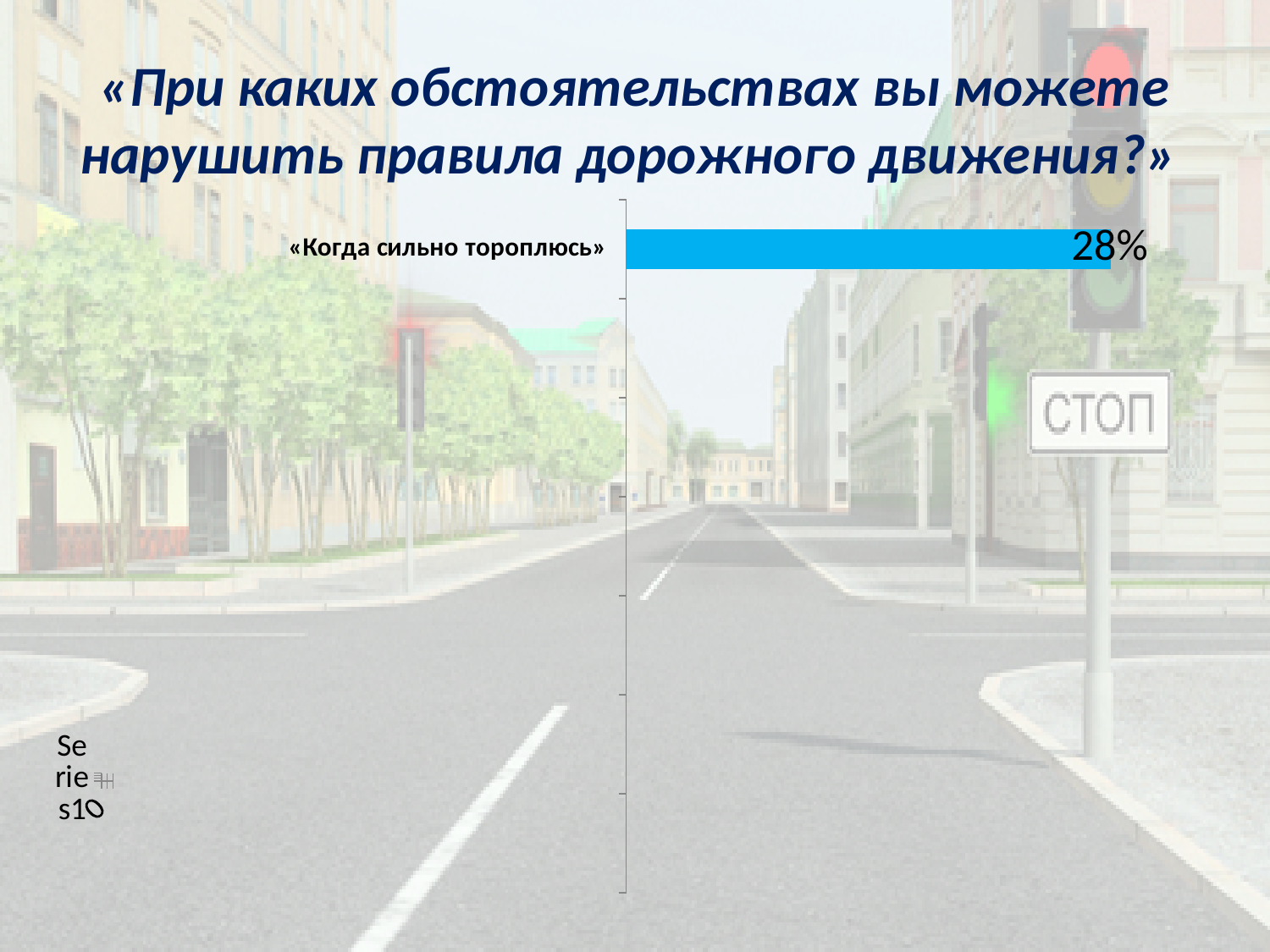
What question is given as the title above the chart? «При каких обстоятельствах вы можете нарушить правила дорожного движения?» What colour is the bar for «Когда сильно тороплюсь»? blue What is the label of the category whose bar shows 28%? «Когда сильно тороплюсь» What value is shown for the category «Когда сильно тороплюсь»? 28% How many bars are plotted on the chart? 1 What kind of chart is shown on the slide? bar chart